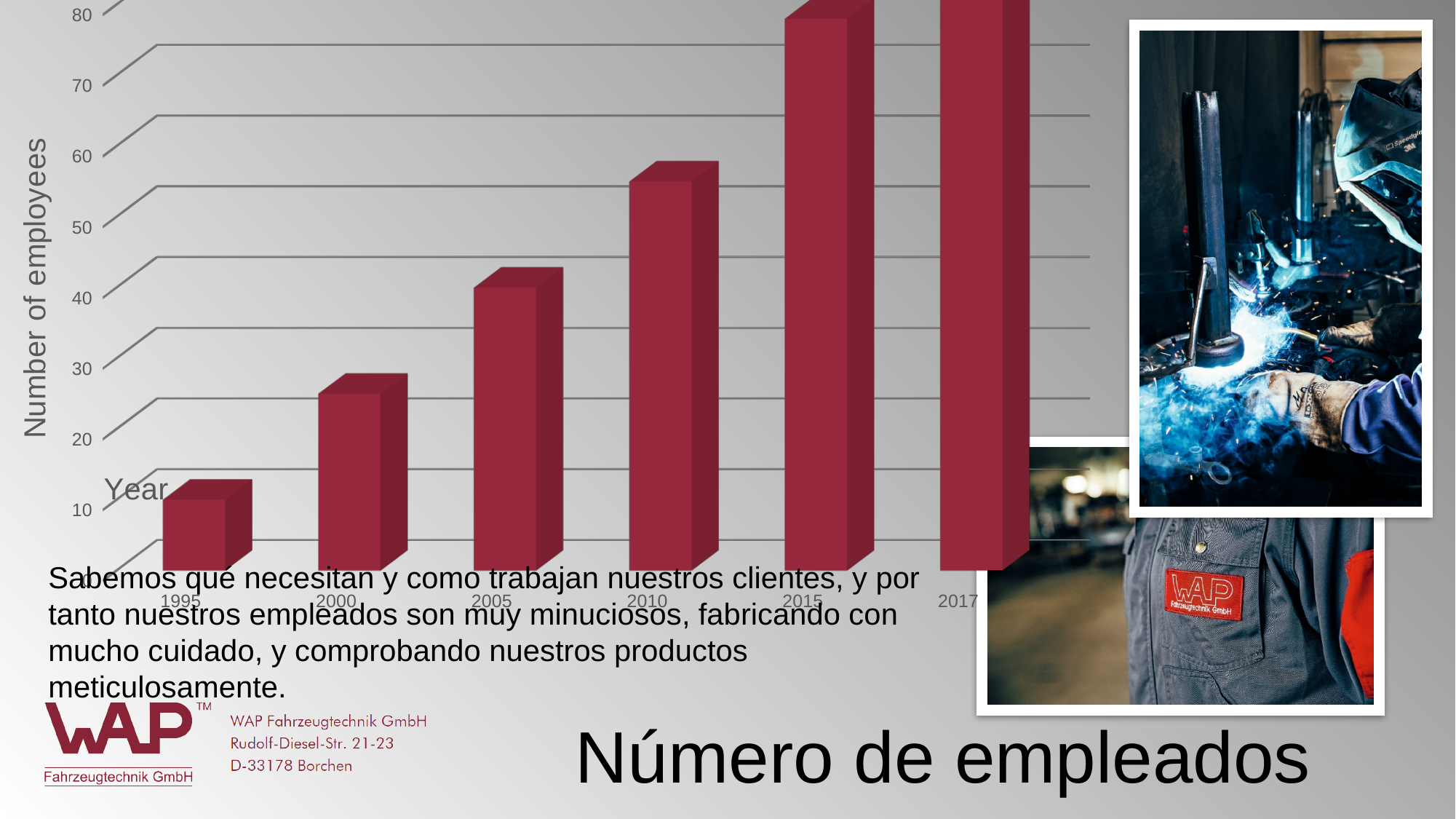
Is the value for 2005 greater or less than 50? less Do the values in the chart rise or fall from 1995 to 2017? rise Which year has the highest number of employees in the chart? 2017 What kind of chart is shown on the slide? bar chart Is the value for 2010 greater or less than 50? greater Is the value for 2015 greater or less than 70? greater Which year has the lowest number of employees in the chart? 1995 How many years are plotted on the x axis of the chart? 6 Which year has more employees, 2005 or 2010? 2010 What is the label of the vertical axis of the chart? Number of employees